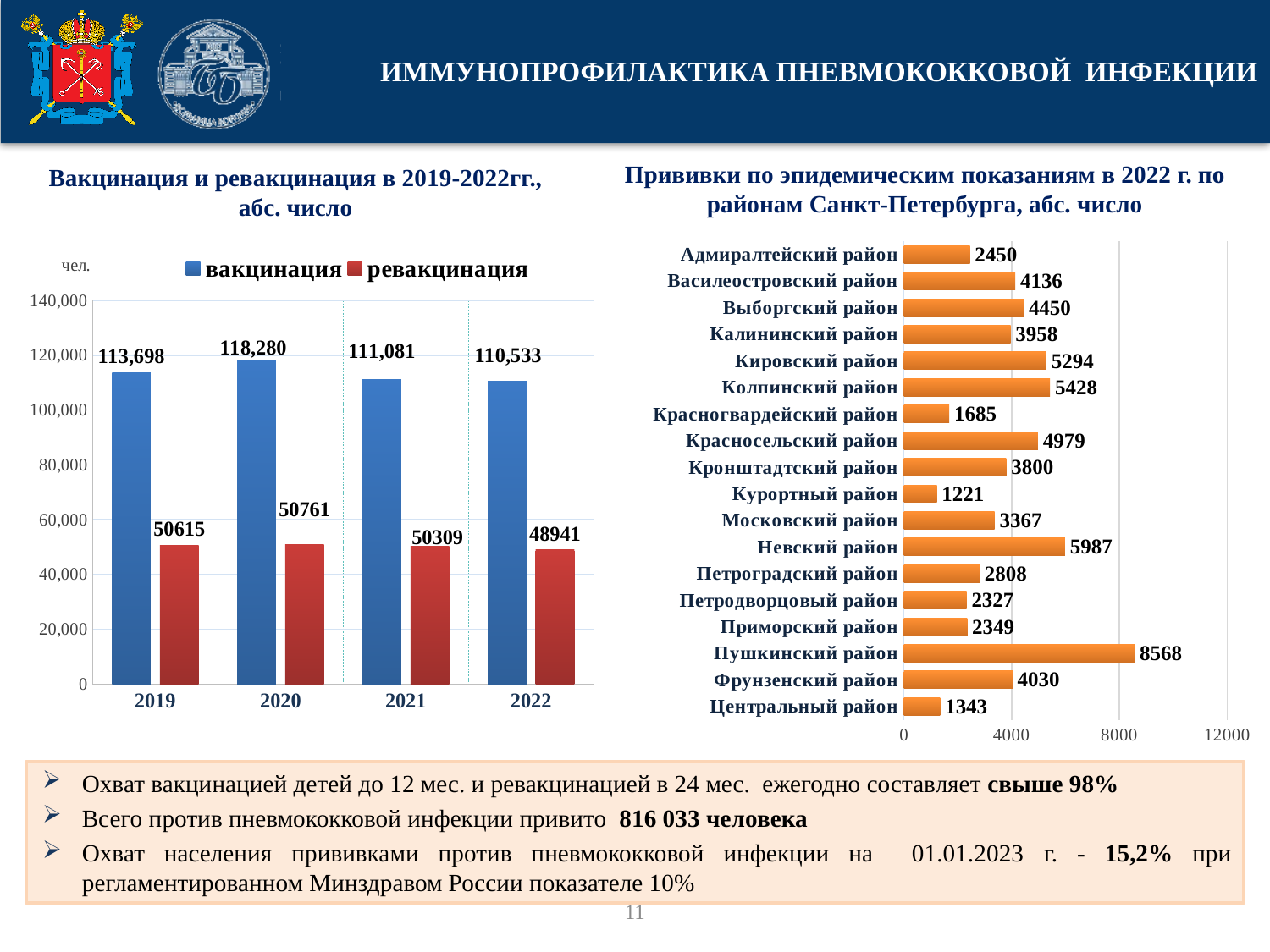
In the left chart 'Вакцинация и ревакцинация в 2019-2022гг., абс. число', which year has the lowest ревакцинация value? 2022 In the right chart 'Прививки по эпидемическим показаниям в 2022 г. по районам Санкт-Петербурга, абс. число', what is the value for Невский район? 5987 In the right chart 'Прививки по эпидемическим показаниям в 2022 г. по районам Санкт-Петербурга, абс. число', which is larger: the value for Кировский район or Колпинский район? Колпинский район In the left chart 'Вакцинация и ревакцинация в 2019-2022гг., абс. число', which year has the highest вакцинация value? 2020 In the left chart 'Вакцинация и ревакцинация в 2019-2022гг., абс. число', what is the value for ревакцинация in 2022? 48941 In the left chart 'Вакцинация и ревакцинация в 2019-2022гг., абс. число', what is the value for вакцинация in 2020? 118,280 In the left chart 'Вакцинация и ревакцинация в 2019-2022гг., абс. число', how many series does the legend list? 2 In the left chart 'Вакцинация и ревакцинация в 2019-2022гг., абс. число', does the вакцинация value rise or fall from 2020 to 2022? fall In the right chart 'Прививки по эпидемическим показаниям в 2022 г. по районам Санкт-Петербурга, абс. число', which district has the highest value? Пушкинский район In the left chart 'Вакцинация и ревакцинация в 2019-2022гг., абс. число', what is the difference between the вакцинация values for 2020 and 2021? 7,199 In the right chart 'Прививки по эпидемическим показаниям в 2022 г. по районам Санкт-Петербурга, абс. число', which district has the lowest value? Курортный район In the right chart 'Прививки по эпидемическим показаниям в 2022 г. по районам Санкт-Петербурга, абс. число', how many districts are shown? 18